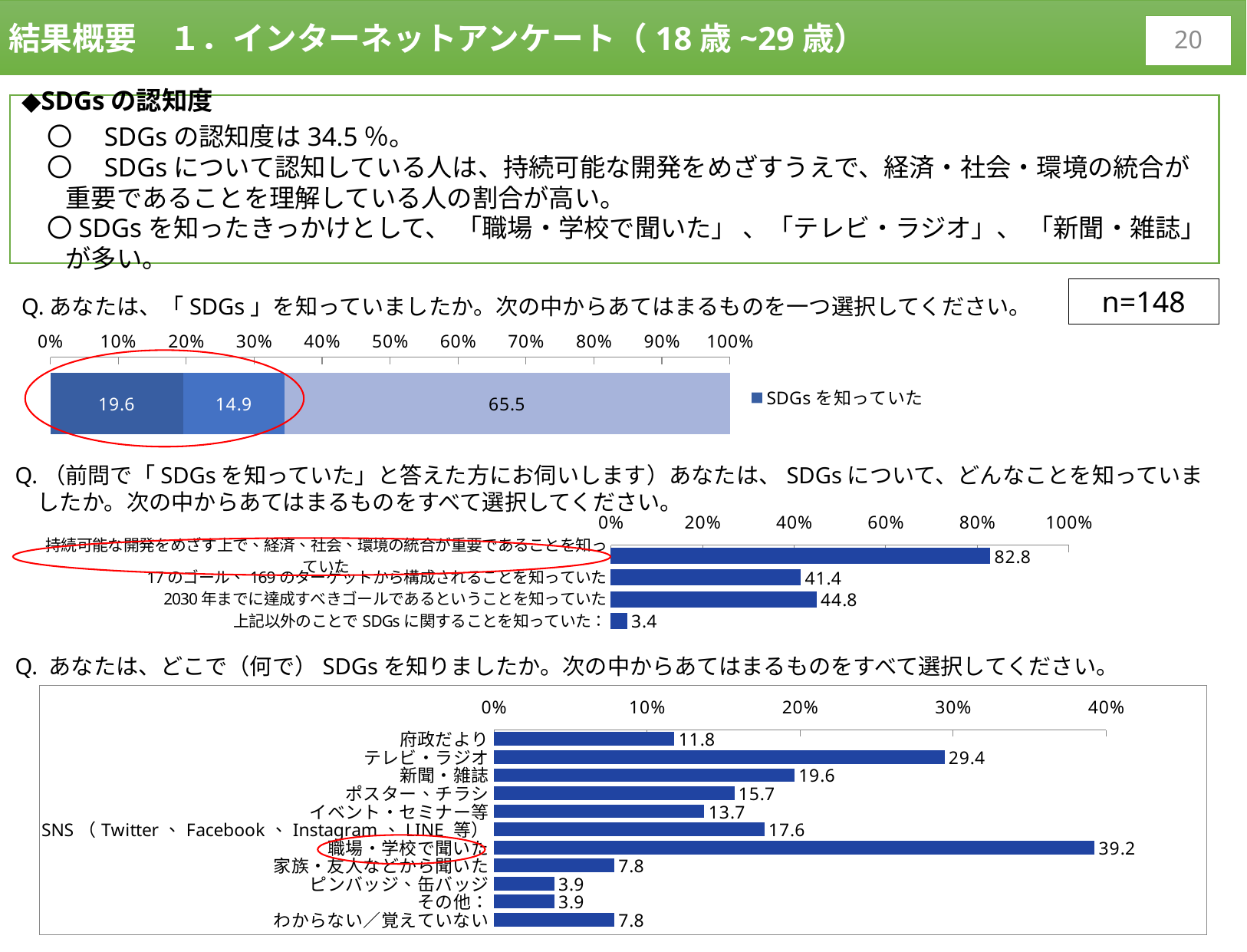
In the middle chart (what people knew about SDGs), which category has the lowest value? 上記以外のことでSDGsに関することを知っていた In the bottom chart (where people learned about SDGs), what is the value for 府政だより? 11.8 In the bottom chart (where people learned about SDGs), which is larger: 新聞・雑誌 or SNS（Twitter、Facebook、Instagram、LINE等）? 新聞・雑誌 In the bottom chart (where people learned about SDGs), how many categories are shown? 11 In the bottom chart (where people learned about SDGs), what is the difference between 職場・学校で聞いた and テレビ・ラジオ? 9.8 In the bottom chart (where people learned about SDGs), what is the value for テレビ・ラジオ? 29.4 In the top stacked bar chart (whether respondents knew SDGs), what is the value of the largest segment? 65.5 In the bottom chart (where people learned about SDGs), which category has the highest value? 職場・学校で聞いた In the middle chart (what people knew about SDGs), how many categories are shown? 4 What type of chart is the top chart (whether respondents knew SDGs)? Stacked bar chart In the middle chart (what people knew about SDGs), what is the difference between the highest value and 41.4? 41.4 In the middle chart (what people knew about SDGs), what is the value for 2030年までに達成すべきゴールであるということを知っていた? 44.8